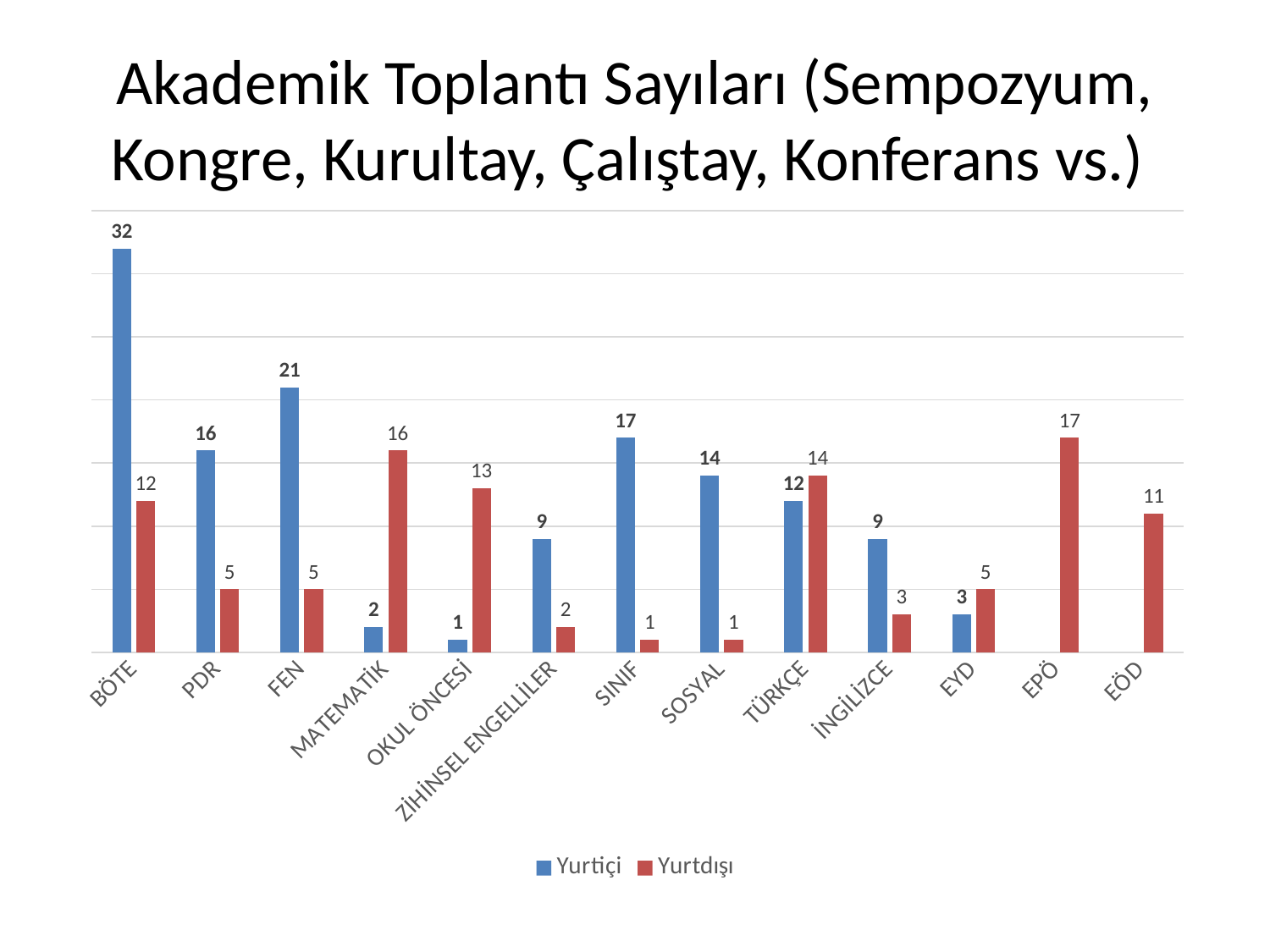
What is the Yurtdışı value for MATEMATİK? 16 What is the Yurtdışı value for EÖD? 11 How many categories are shown on the x axis? 13 What is the Yurtiçi value for BÖTE? 32 Which is larger for TÜRKÇE, the Yurtiçi value or the Yurtdışı value? Yurtdışı What is the total of the Yurtiçi and Yurtdışı values for OKUL ÖNCESİ? 14 Which category has the highest Yurtiçi value? BÖTE What kind of chart is shown on the slide? Bar chart Which category has the lowest Yurtdışı value? SINIF and SOSYAL (1 each) Which colour represents the Yurtdışı series? Red What is the difference between the Yurtiçi and Yurtdışı values for FEN? 16 How many series does the legend list? 2